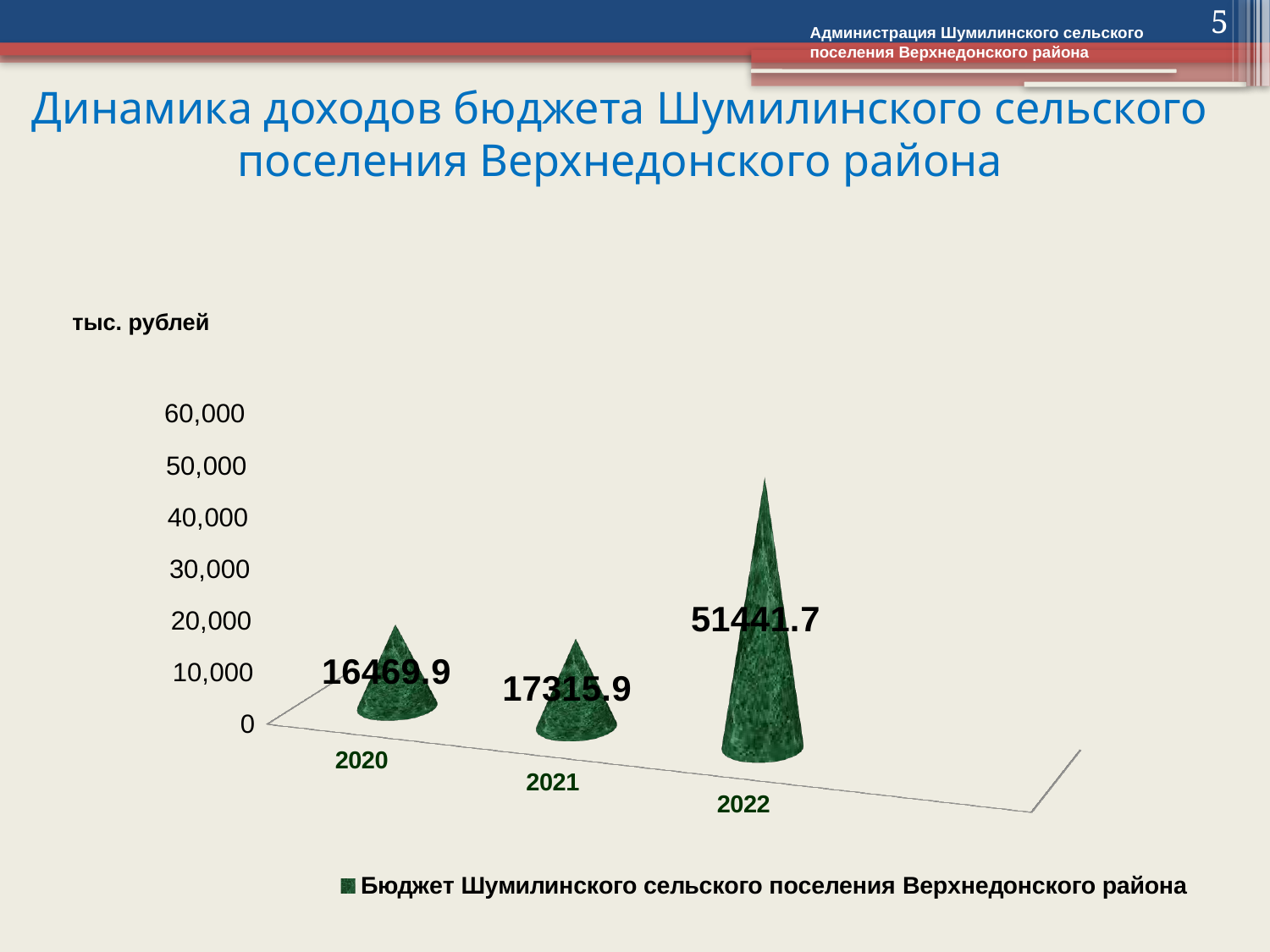
Which year has the highest budget revenue? 2022 What is the difference between the 2021 and 2020 values? 846.0 What is the difference between the 2022 and 2021 values? 34125.8 Which is larger, the value for 2021 or the value for 2020? 2021 What is the budget revenue value shown for 2022? 51441.7 What is the budget revenue value shown for 2020? 16469.9 What unit of measurement is indicated above the chart? тыс. рублей How many years are shown on the x axis? 3 How many series does the legend list? 1 Which year has the lowest budget revenue? 2020 What is the budget revenue value shown for 2021? 17315.9 Do the values rise or fall from 2020 to 2022? rise